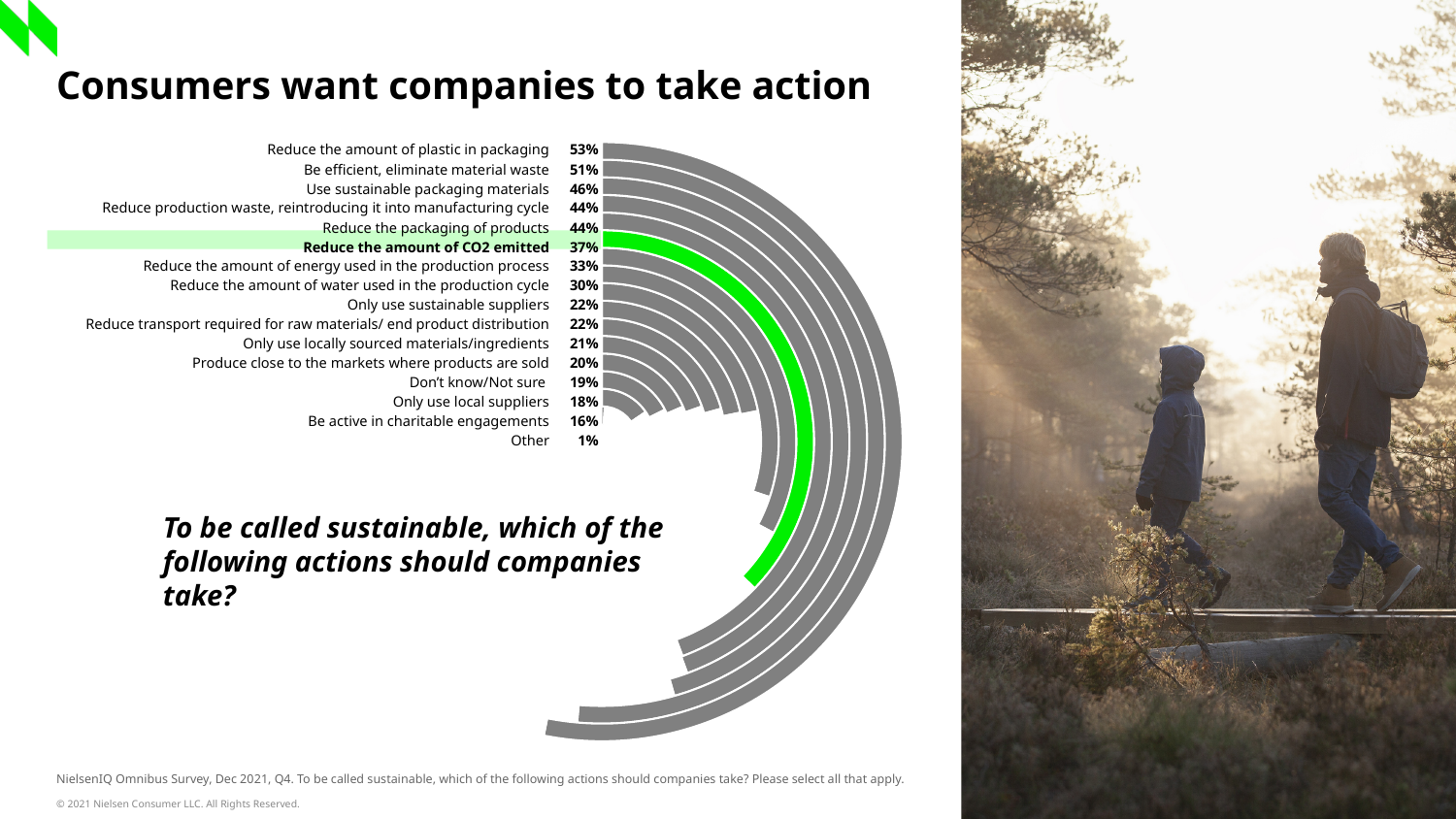
Which action has the highest percentage on the chart? Reduce the amount of plastic in packaging What is the difference between 'Reduce the amount of CO2 emitted' and 'Reduce the amount of energy used in the production process'? 4% How many categories are plotted on the chart? 16 What is the value for 'Reduce the amount of CO2 emitted'? 37% What is the value for 'Don't know/Not sure'? 19% Which category's bar is highlighted in green? Reduce the amount of CO2 emitted Which is larger: 'Use sustainable packaging materials' or 'Reduce the amount of water used in the production cycle'? Use sustainable packaging materials What percentage is shown for 'Only use local suppliers'? 18% What kind of chart is shown on the slide? Doughnut chart (concentric radial bars) What is the difference between 'Reduce the amount of plastic in packaging' and 'Be efficient, eliminate material waste'? 2% What percentage of consumers said companies should reduce the amount of plastic in packaging? 53% Which category has the lowest percentage on the chart? Other